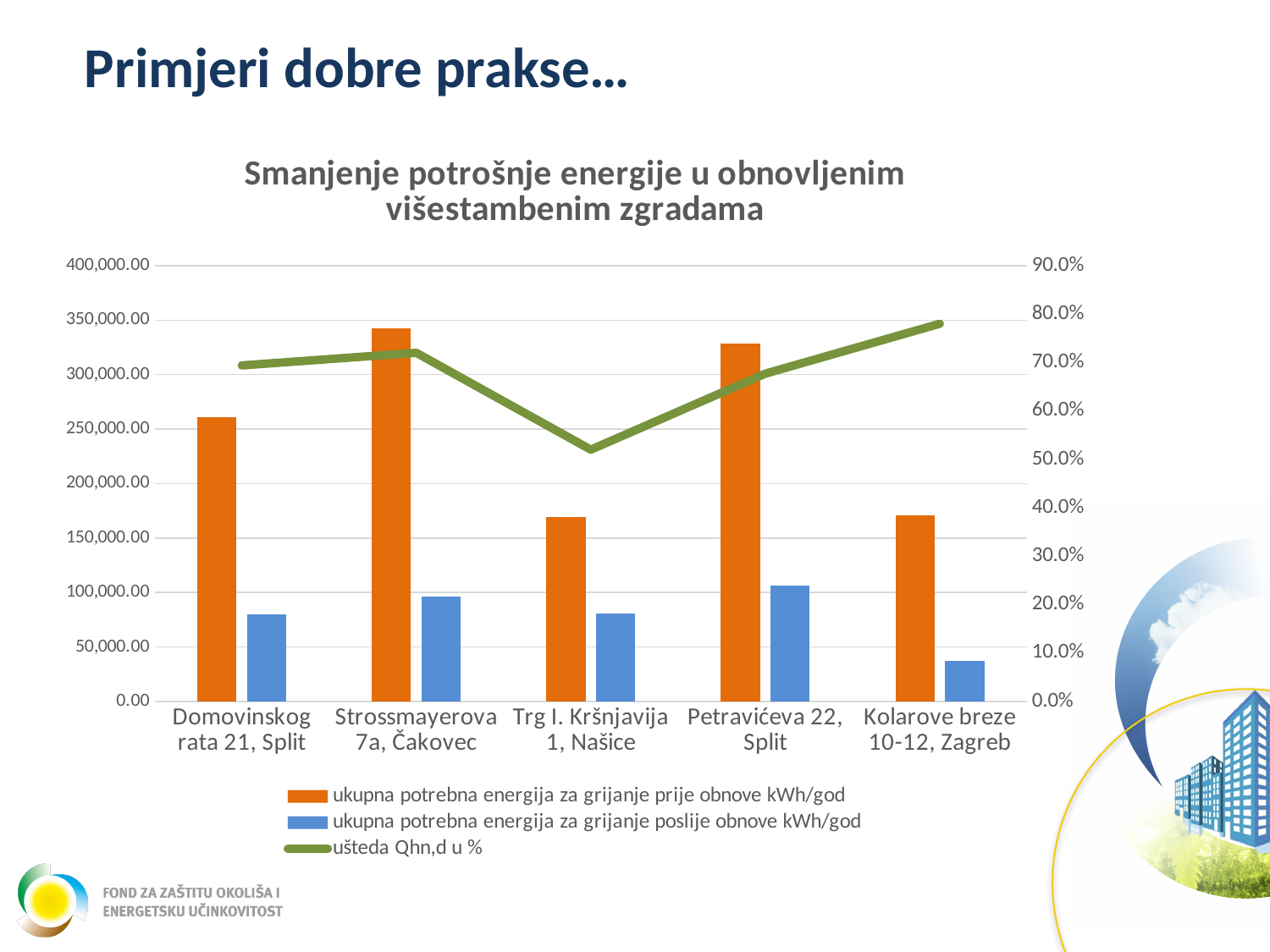
How many series does the chart legend list? 3 Which building has the lowest 'ušteda Qhn,d u %' on the line? Trg I. Kršnjavija 1, Našice Which building has the highest 'ušteda Qhn,d u %' on the line? Kolarove breze 10-12, Zagreb What is the title of the chart? Smanjenje potrošnje energije u obnovljenim višestambenim zgradama What kind of chart is shown on the slide? A combined bar and line chart Which building has the lowest value for 'ukupna potrebna energija za grijanje poslije obnove kWh/god'? Kolarove breze 10-12, Zagreb Is the value for 'ukupna potrebna energija za grijanje prije obnove kWh/god' for Strossmayerova 7a, Čakovec greater or less than 300,000.00? greater How many buildings (categories) are shown on the x axis of the chart? 5 Which is larger for Petravićeva 22, Split: the energy before renovation (prije obnove) or after renovation (poslije obnove)? Before renovation (prije obnove) Is the value for 'ukupna potrebna energija za grijanje poslije obnove kWh/god' for Kolarove breze 10-12, Zagreb greater or less than 50,000.00? less Which building has the highest value for 'ukupna potrebna energija za grijanje poslije obnove kWh/god'? Petravićeva 22, Split Which building has the highest value for 'ukupna potrebna energija za grijanje prije obnove kWh/god'? Strossmayerova 7a, Čakovec